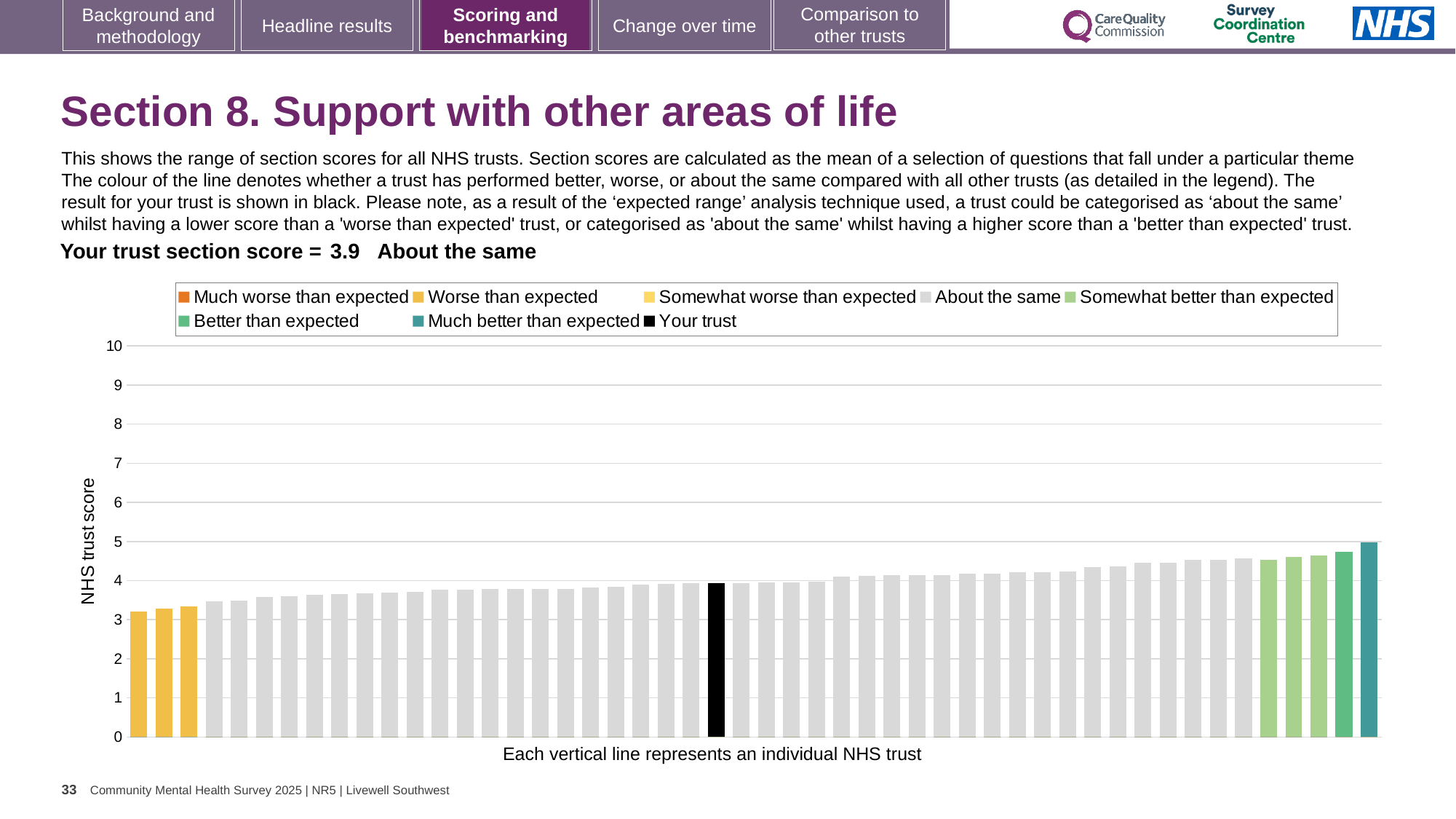
How many entries does the chart legend list? 8 Is the value of the lowest bar (leftmost trust) greater or less than 3? greater What is the label of the y axis? NHS trust score Is the value of the black 'Your trust' bar greater or less than 4? less What is the highest value shown on the y axis? 10 Is the value of the highest bar (rightmost trust) greater or less than 6? less What colour is the bar representing your trust? Black What is the section score for your trust? 3.9 What kind of chart is shown on the slide? Bar chart Do the bar values rise or fall from left to right along the x axis? Rise Which category is your trust's section score placed in? About the same